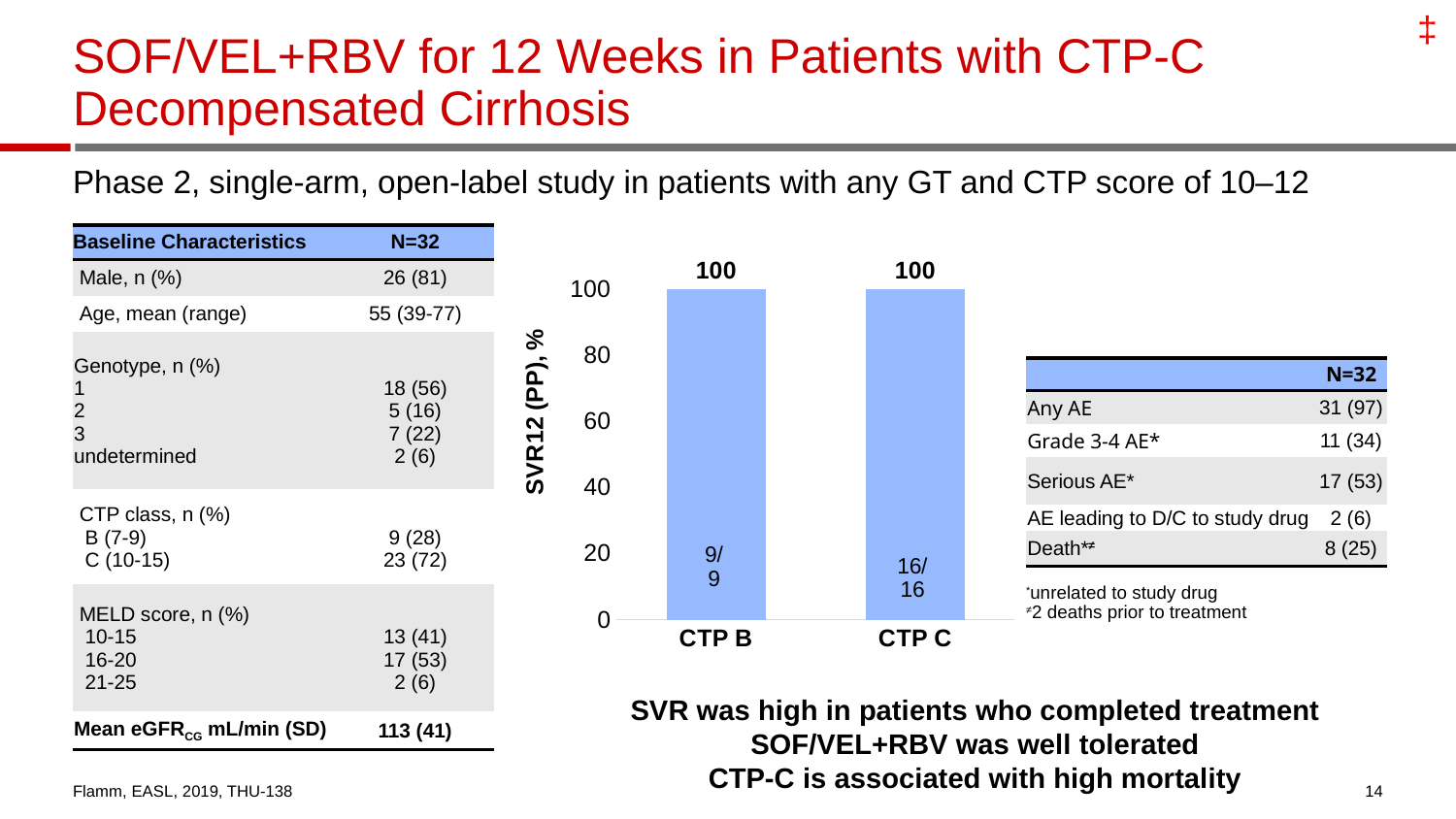
How many categories are shown on the x axis of the chart? 2 What is the maximum value shown on the y axis of the chart? 100 What is the difference between the SVR12 values for CTP B and CTP C? 0 What is the SVR12 (PP) value for CTP C? 100 What fraction of patients is printed inside the CTP C bar? 16/16 Do the SVR12 values rise, fall, or stay the same from CTP B to CTP C? stay the same What is the label on the y axis of the chart? SVR12 (PP), % What fraction of patients is printed inside the CTP B bar? 9/9 Is the SVR12 value for CTP C greater or less than 80? greater What is the SVR12 (PP) value for CTP B? 100 What kind of chart is shown on the slide? bar chart